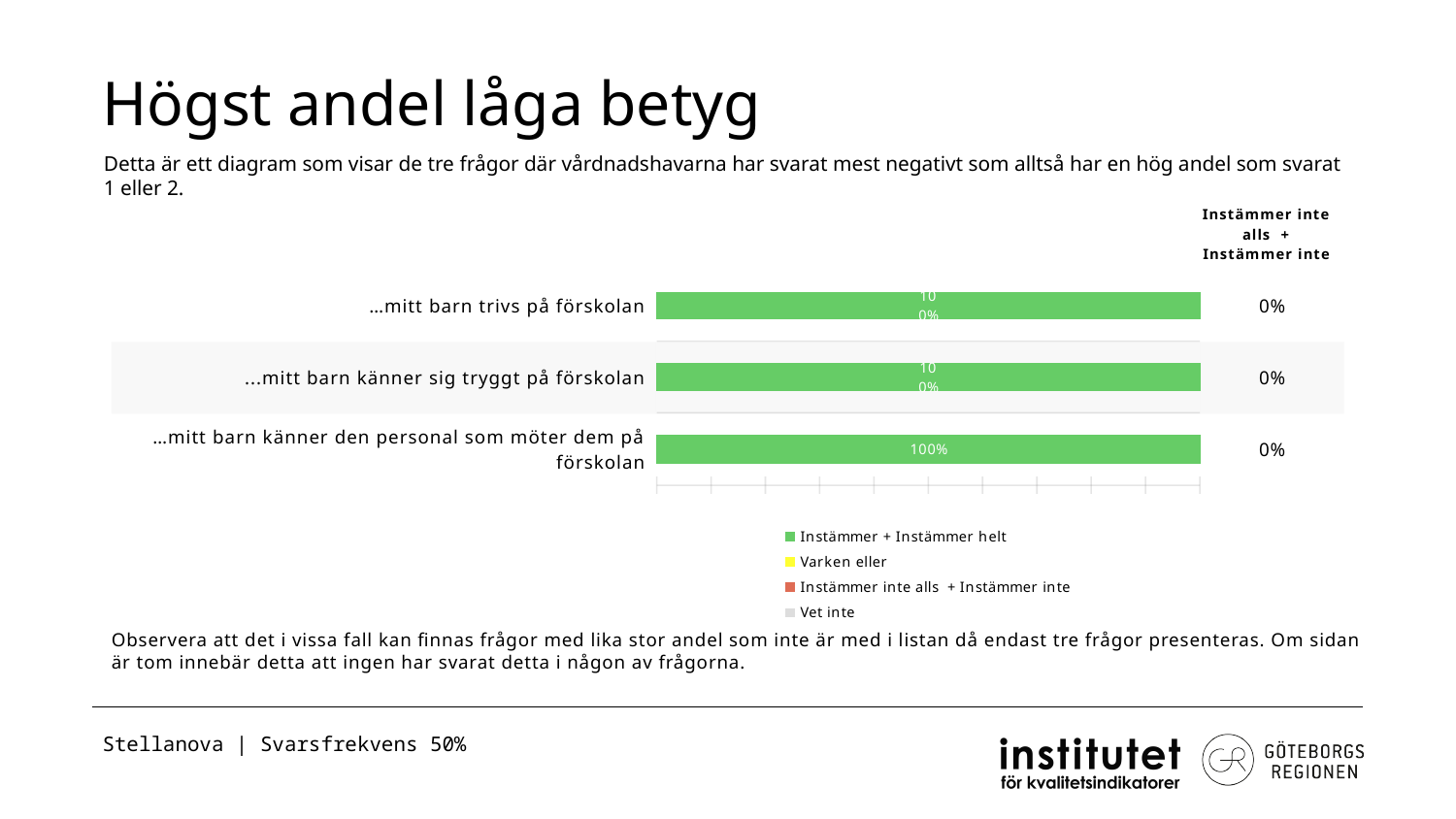
How many series does the chart legend list? 4 What kind of chart is shown on the slide? bar chart What is the 'Instämmer inte alls + Instämmer inte' value shown for '…mitt barn trivs på förskolan'? 0% What is the 'Instämmer inte alls + Instämmer inte' value shown for '…mitt barn känner den personal som möter dem på förskolan'? 0% What is the value of the 'Instämmer + Instämmer helt' segment for '…mitt barn känner den personal som möter dem på förskolan'? 100% What is the label of the third (bottom) category in the chart? …mitt barn känner den personal som möter dem på förskolan Which legend entry is shown in green? Instämmer + Instämmer helt Which legend entry is shown in yellow? Varken eller What is the 'Instämmer inte alls + Instämmer inte' value shown for '…mitt barn känner sig tryggt på förskolan'? 0% Is the green segment for '…mitt barn känner sig tryggt på förskolan' greater or less than 50%? greater Is the green segment for '…mitt barn trivs på förskolan' greater or less than 50%? greater How many categories (questions) are plotted in the chart? 3